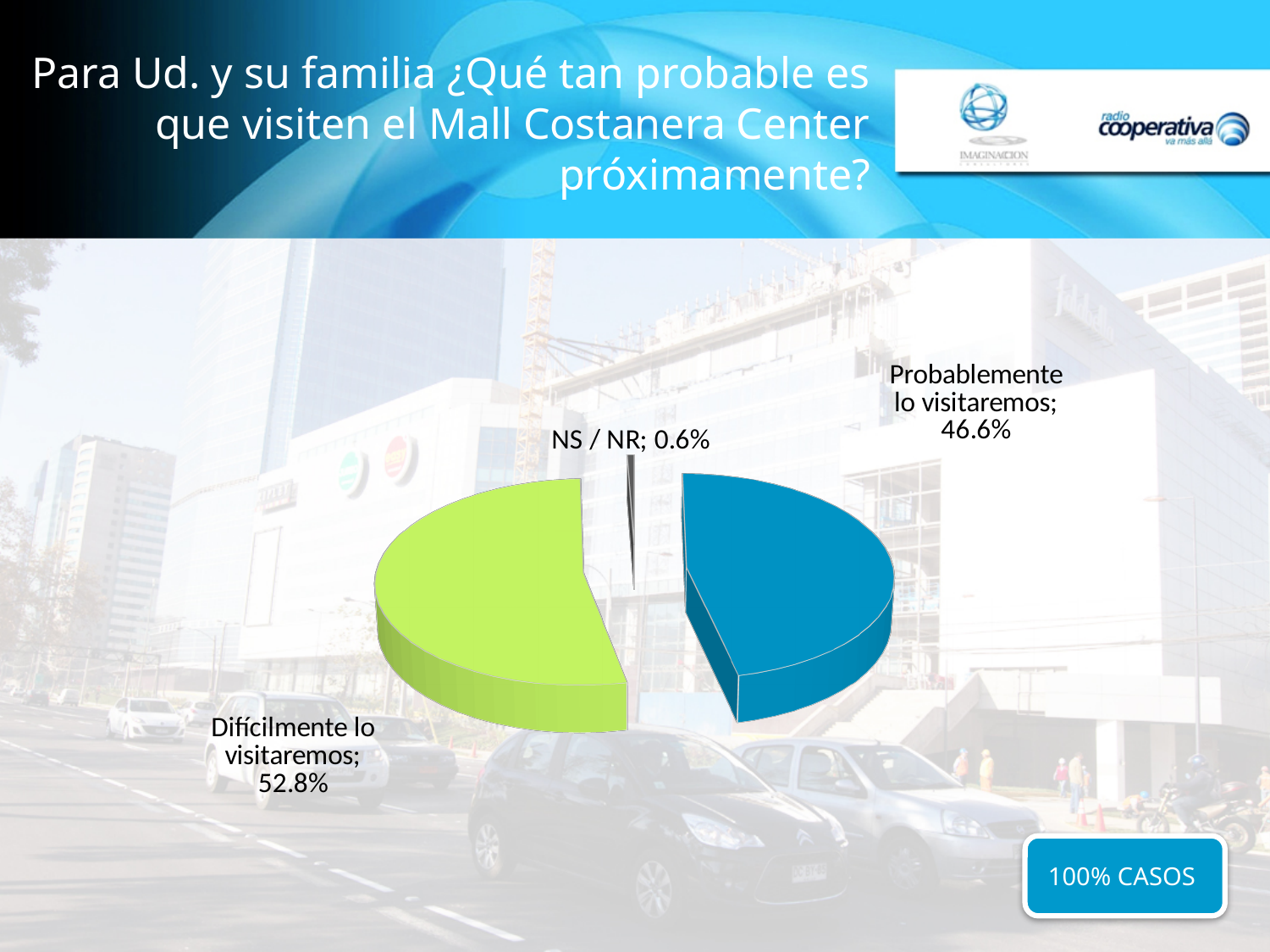
What percentage is shown for "NS / NR"? 0.6% Which category has the largest share of the pie? Difícilmente lo visitaremos What percentage of respondents answered "Probablemente lo visitaremos"? 46.6% What colour is the slice for "Difícilmente lo visitaremos"? green What colour is the slice for "Probablemente lo visitaremos"? blue What percentage of respondents answered "Difícilmente lo visitaremos"? 52.8% What is the combined share of "Probablemente lo visitaremos" and "NS / NR"? 47.2% What is the difference in percentage points between "Difícilmente lo visitaremos" and "Probablemente lo visitaremos"? 6.2 How many slices does the pie chart have? 3 What kind of chart is shown on the slide? pie chart Which category has the smallest share of the pie? NS / NR Which is larger: the share for "Probablemente lo visitaremos" or the share for "Difícilmente lo visitaremos"? Difícilmente lo visitaremos